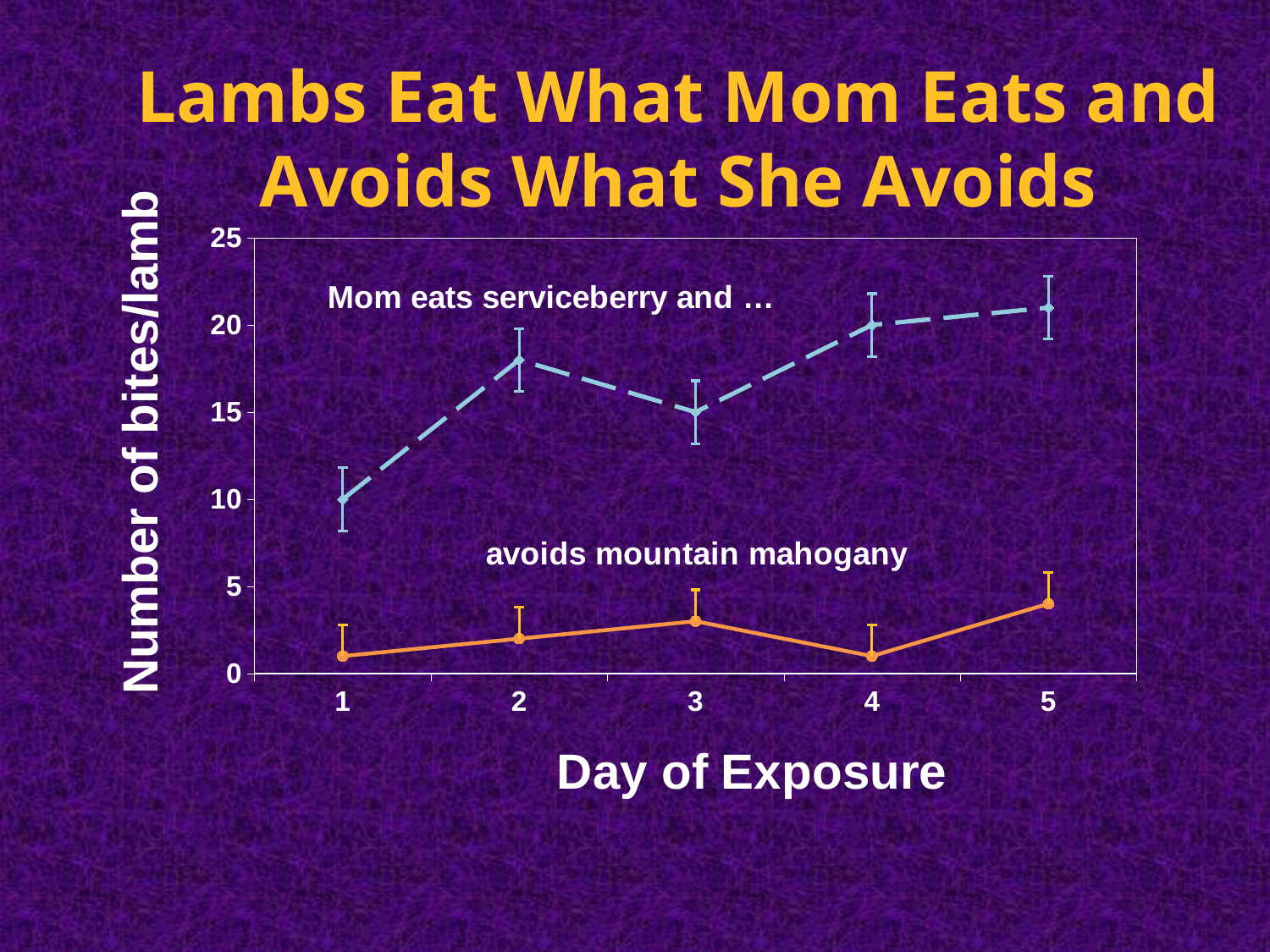
On which day is the 'avoids mountain mahogany' series at its highest? Day 5 What is the number of bites/lamb for the 'Mom eats serviceberry' series on day 4? 20 What is the number of bites/lamb for the 'Mom eats serviceberry' series on day 1? 10 How many days of exposure are plotted on the x axis? 5 On which day is the 'Mom eats serviceberry' series at its lowest? Day 1 On day 3, which series has the larger number of bites/lamb: 'Mom eats serviceberry' or 'avoids mountain mahogany'? Mom eats serviceberry What is the number of bites/lamb for the 'Mom eats serviceberry' series on day 3? 15 Is the value for the 'avoids mountain mahogany' series on day 5 greater or less than 5? less Is the value for the 'Mom eats serviceberry' series on day 2 greater or less than 15? greater What is the label of the y axis? Number of bites/lamb What kind of chart is shown on the slide? line chart How many data series are plotted on the chart? 2